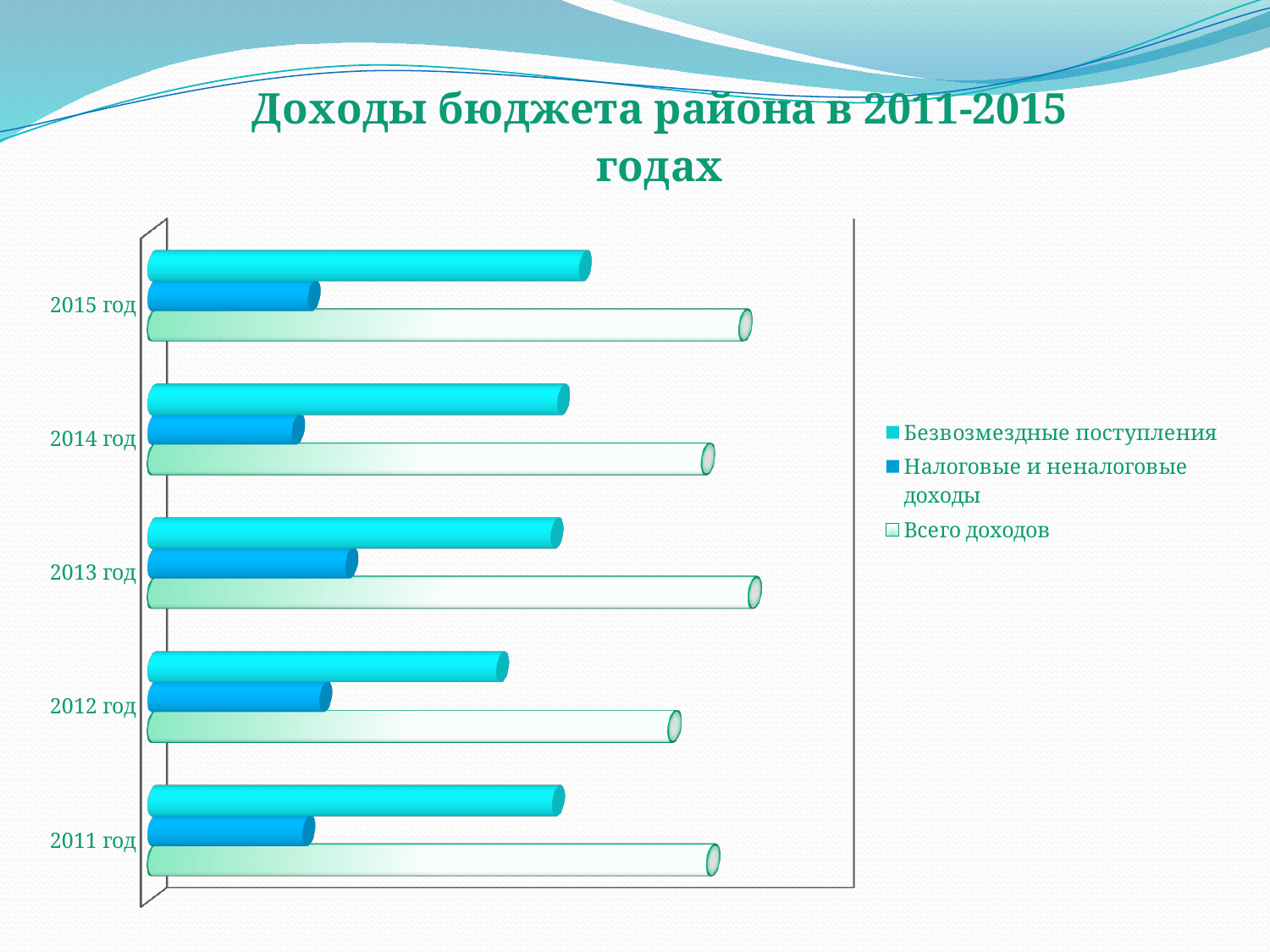
Is the bar for Безвозмездные поступления longer in 2015 год or in 2012 год? 2015 год What kind of chart is shown on the slide? bar chart How many years (categories) are shown on the chart? 5 In which year is the bar for Всего доходов the shortest? 2012 год In which year is the bar for Безвозмездные поступления the shortest? 2012 год In 2011 год, which series has the longest bar? Всего доходов Which series is shown with the light green bars? Всего доходов Is the bar for Налоговые и неналоговые доходы longer in 2013 год or in 2014 год? 2013 год What is the title of the chart? Доходы бюджета района в 2011-2015 годах In which year is the bar for Налоговые и неналоговые доходы the longest? 2013 год How many series does the legend list? 3